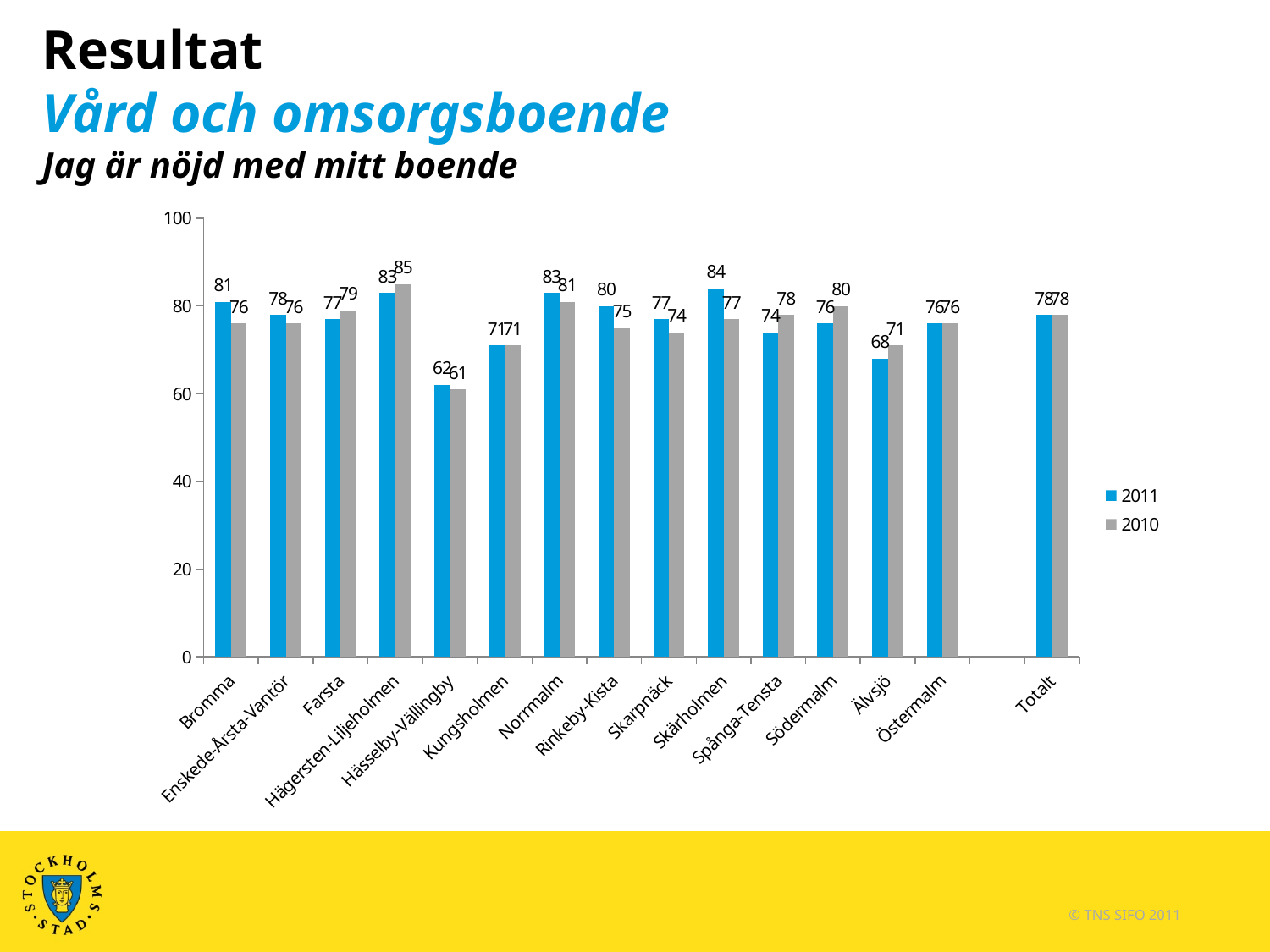
What is the 2010 value for Södermalm? 80 What kind of chart is shown on the slide? bar chart How many series does the legend list? 2 Which colour represents the 2010 series? grey Which category has the lowest 2010 value? Hässelby-Vällingby What is the 2011 value for Bromma? 81 Which is larger for Spånga-Tensta, the 2011 value or the 2010 value? 2010 Is the 2011 value for Älvsjö greater or less than 60? greater What is the 2011 value for Totalt? 78 What is the difference between the 2011 and 2010 values for Skärholmen? 7 Which category has the highest 2011 value? Skärholmen How many categories are shown on the x axis? 15